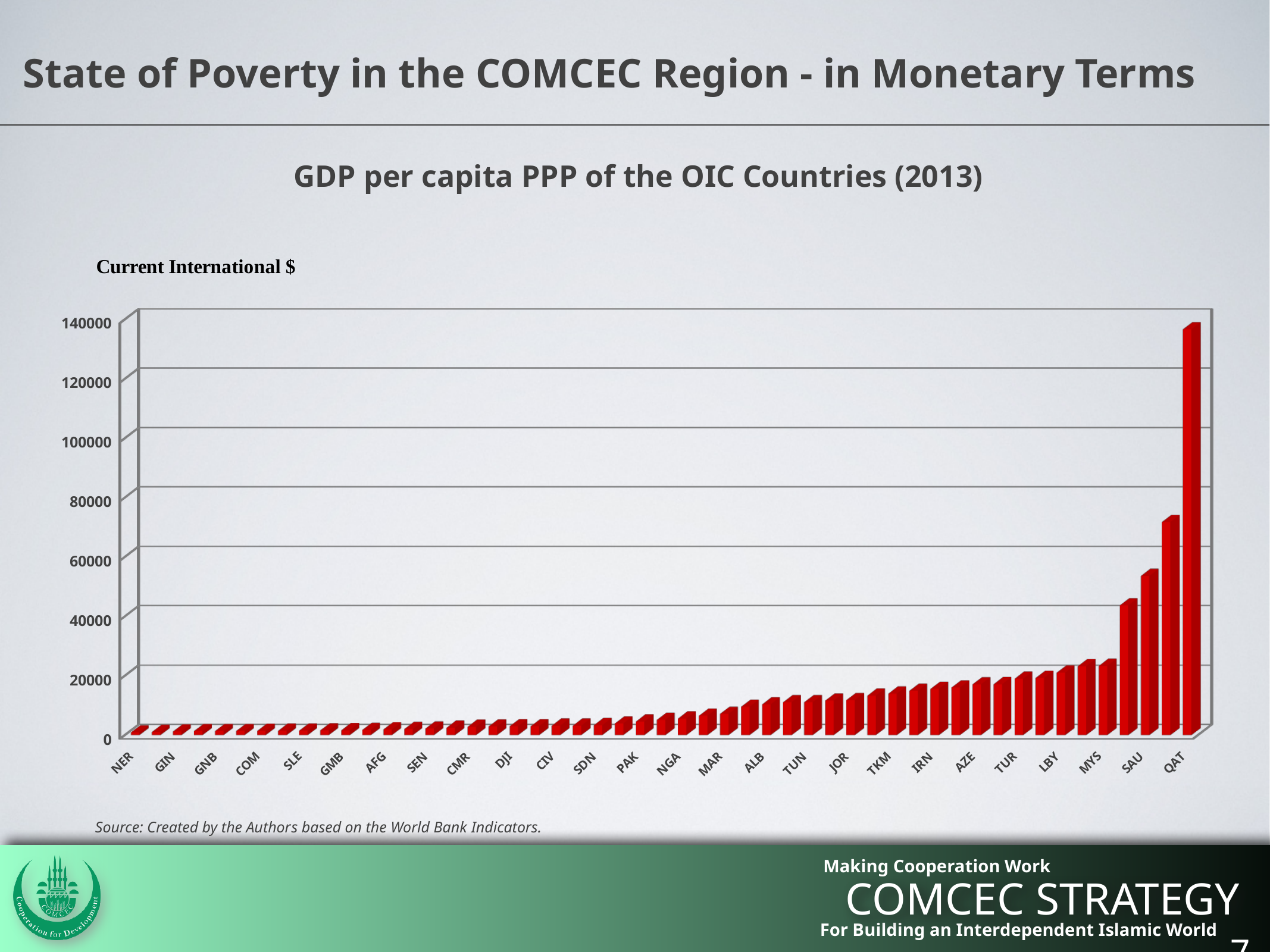
Is the value for IRN greater or less than 20000? less Which has a higher GDP per capita PPP, SAU or MYS? SAU Is the value for QAT greater or less than 120000? greater Which country has the highest GDP per capita PPP in the chart? QAT Is the value for MYS greater or less than 40000? less What unit label is shown above the vertical axis of the chart? Current International $ What kind of chart is shown on the slide? Bar chart How many country labels are shown on the x axis of the chart? 26 Do the values generally rise or fall moving from left to right along the x axis? Rise What is the title of the chart? GDP per capita PPP of the OIC Countries (2013)